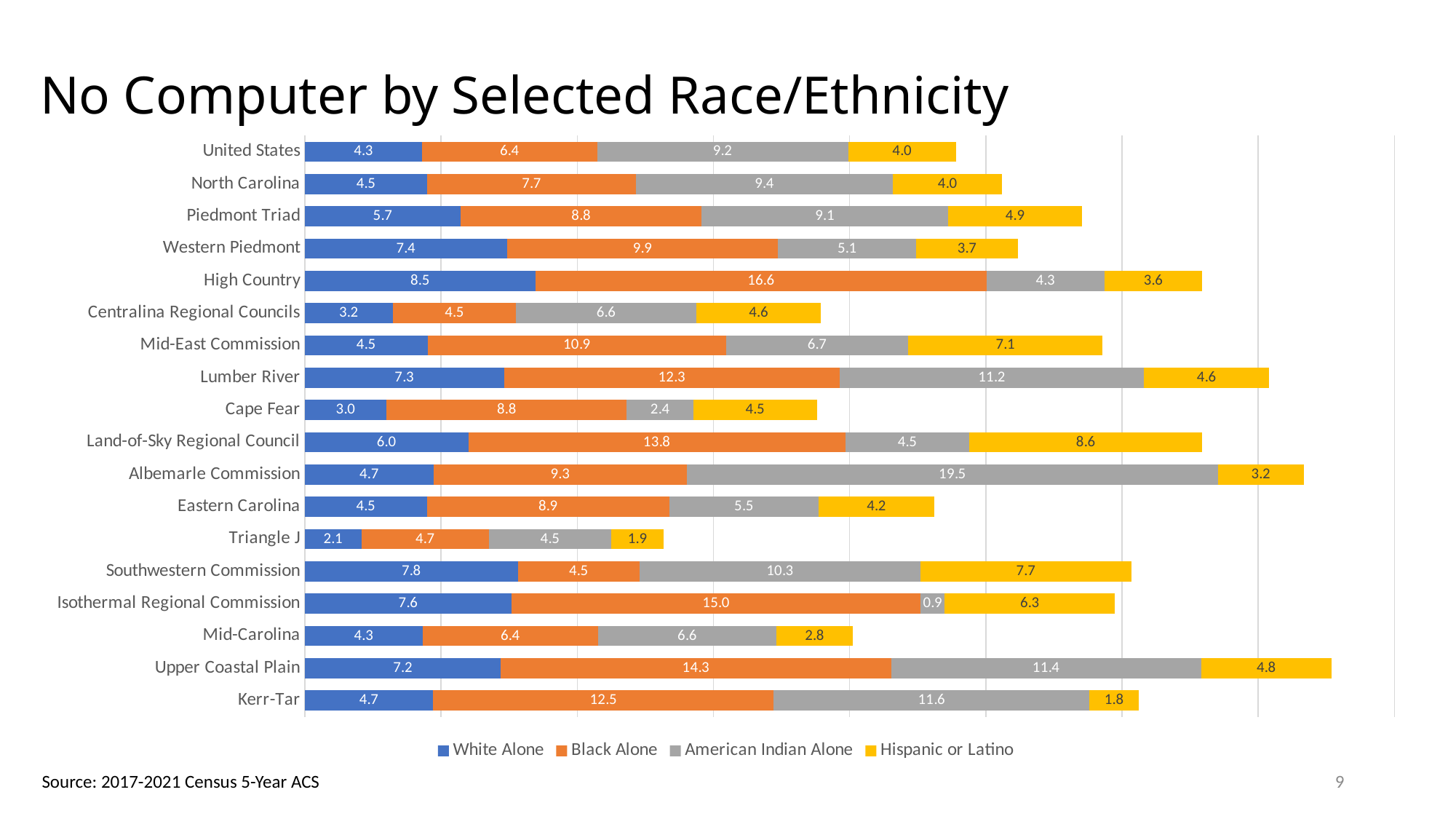
What is the total of the stacked bar for Triangle J? 13.2 Which is larger, the American Indian Alone value for Lumber River or for Upper Coastal Plain? Upper Coastal Plain What is the American Indian Alone value for Albemarle Commission? 19.5 What type of chart is shown on the slide? Stacked bar chart Which region has the highest White Alone value? High Country What is the difference between the Black Alone values for North Carolina and the United States? 1.3 How many series does the legend list? 4 Which region has the lowest Hispanic or Latino value? Kerr-Tar What is the title of the chart? No Computer by Selected Race/Ethnicity How many regions (categories) are plotted in the chart? 18 What is the Hispanic or Latino value for Land-of-Sky Regional Council? 8.6 What is the Black Alone value for High Country? 16.6